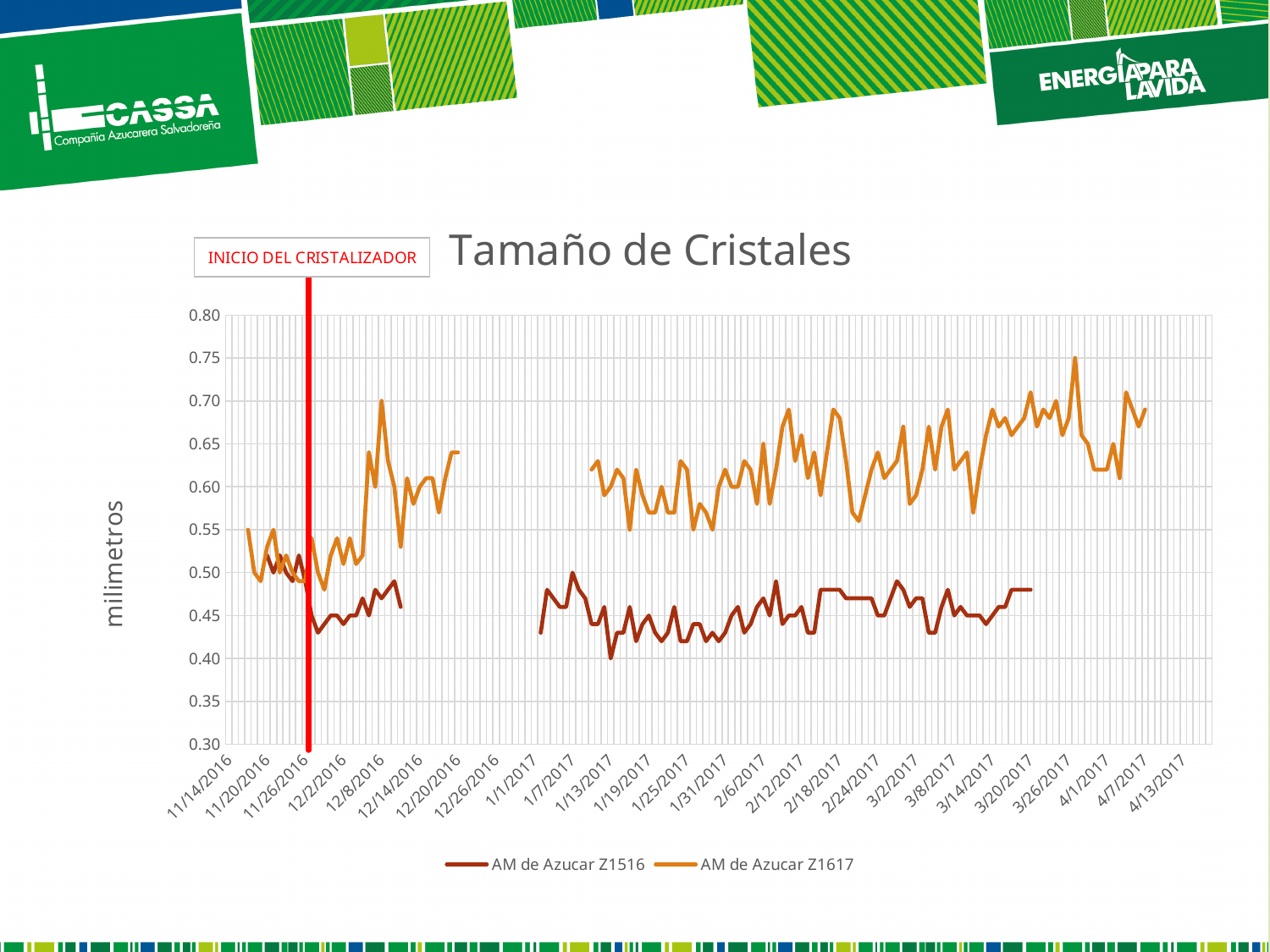
Is the highest value of the AM de Azucar Z1516 series greater or less than 0.55? less Is the value of AM de Azucar Z1516 around 1/13/2017 greater or less than 0.50? less Is the highest value of the AM de Azucar Z1617 series greater or less than 0.70? greater What is the title of the chart? Tamaño de Cristales What kind of chart is shown on the slide? line chart What label is shown on the vertical axis of the chart? milimetros Which series is plotted with the orange line? AM de Azucar Z1617 Does the AM de Azucar Z1617 series generally rise or fall from November 2016 to April 2017? rise How many series does the legend list? 2 Around 2/12/2017, which series has the higher value, AM de Azucar Z1516 or AM de Azucar Z1617? AM de Azucar Z1617